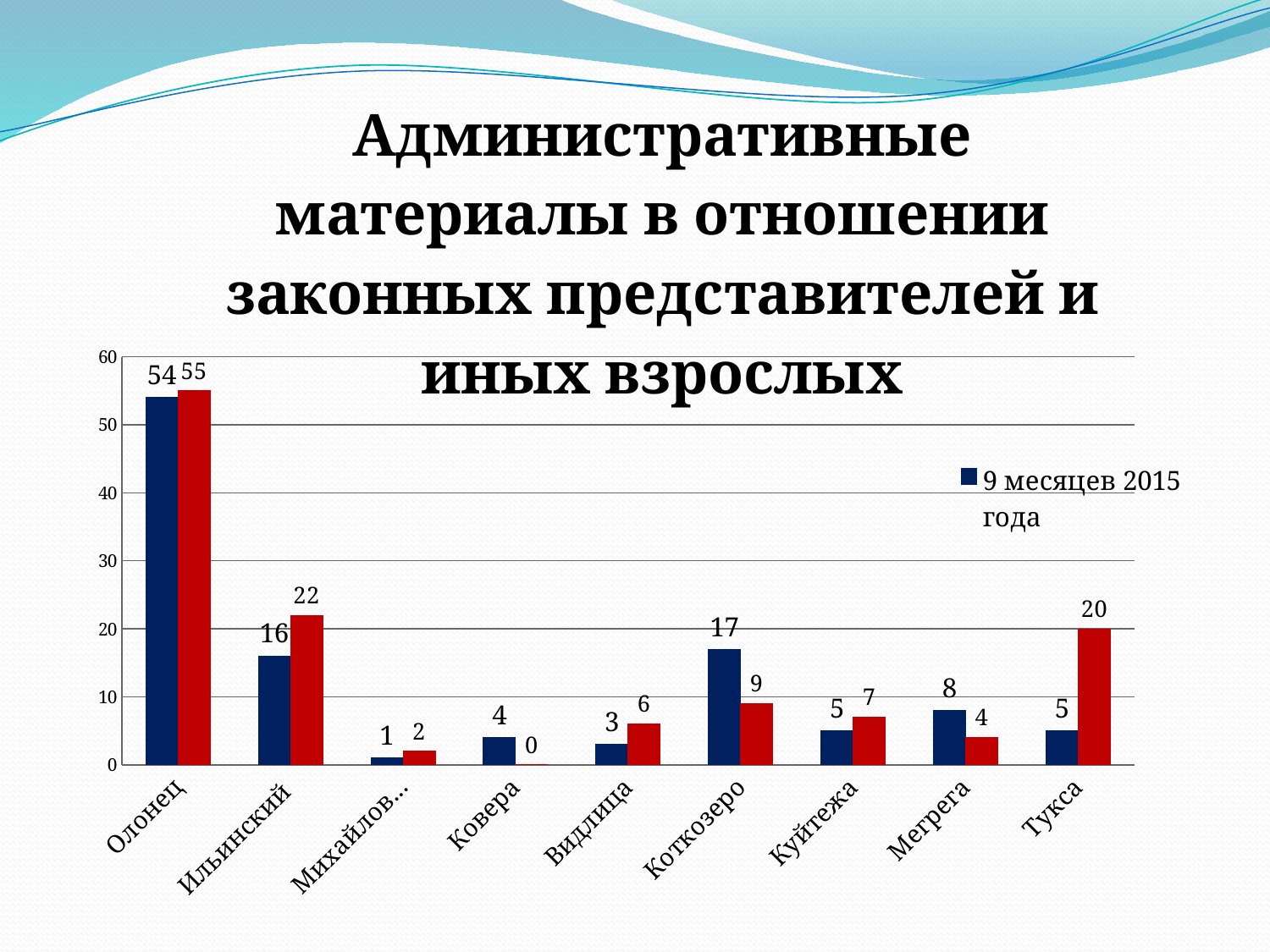
Which category has the lowest value for the red bars? Ковера How many categories are shown on the x axis? 9 What is the difference between the red bar and the '9 месяцев 2015 года' bar for Ильинский? 6 Which category has the highest value in the '9 месяцев 2015 года' series? Олонец Is the value for Олонец in the '9 месяцев 2015 года' series greater or less than 50? greater What is the value for Коткозеро in the '9 месяцев 2015 года' series? 17 What kind of chart is shown on the slide? bar chart What is the value of the red bar for Тукса? 20 For Коткозеро, which is larger: the '9 месяцев 2015 года' bar or the red bar? 9 месяцев 2015 года What is the value of the red bar for Ковера? 0 What is the value for Олонец in the '9 месяцев 2015 года' series? 54 What colour are the bars for the '9 месяцев 2015 года' series? dark blue